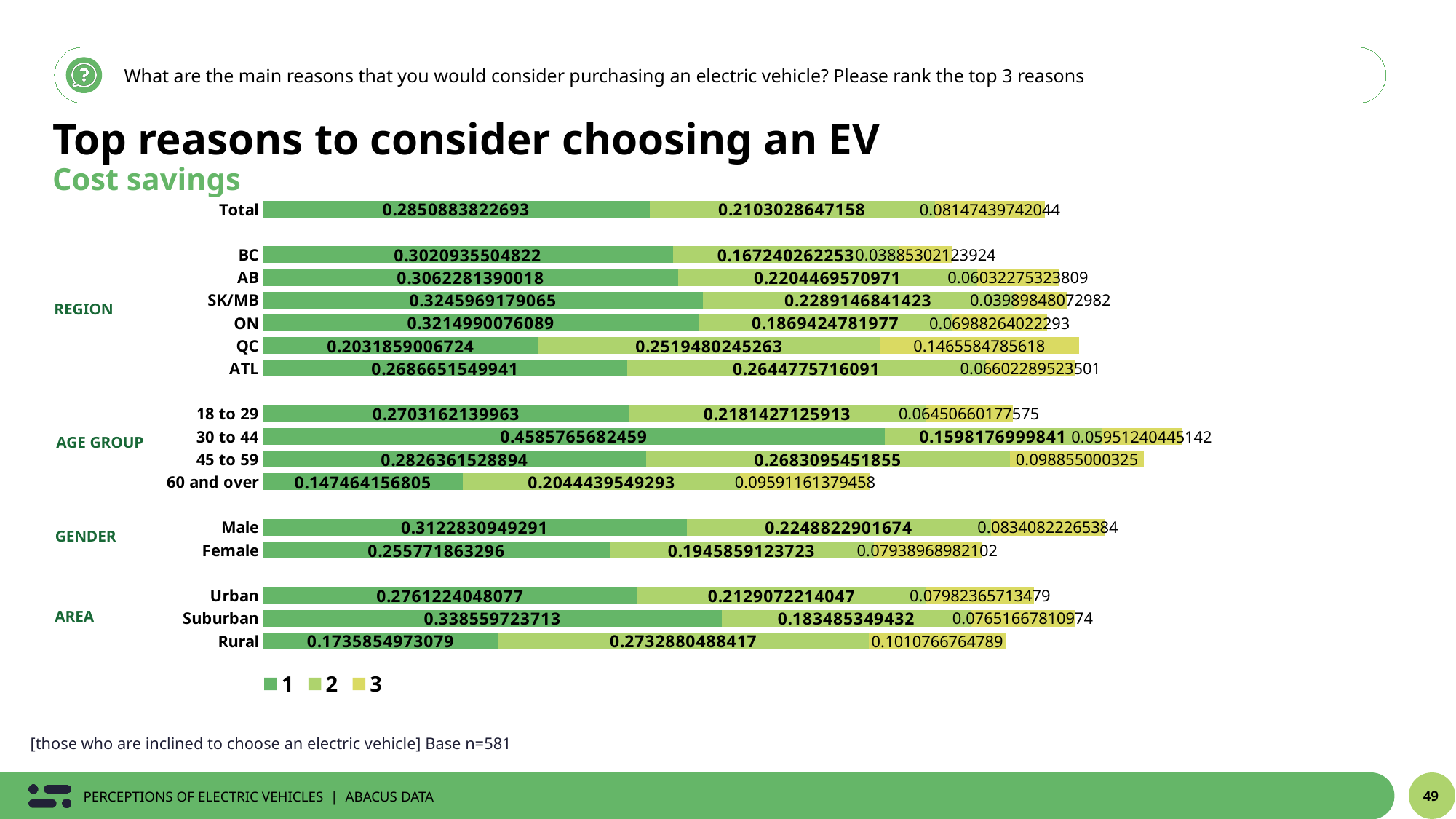
How many categories (bars) are plotted in the chart? 16 What is the difference between the series 1 values for Male and Female? 0.0565112316331 What is the value of series 1 for Total? 0.2850883822693 What is the value of series 2 for QC? 0.2519480245263 What is the total of the stacked bar for QC? 0.6016924037605 Which category has the lowest value for series 1? 60 and over What kind of chart is shown on the slide? Stacked bar chart How many series does the legend list? 3 Which has the larger series 1 value, Urban or Rural? Urban What is the value of series 1 for Suburban? 0.338559723713 Which category has the highest value for series 1? 30 to 44 Which category has the highest value for series 3? QC